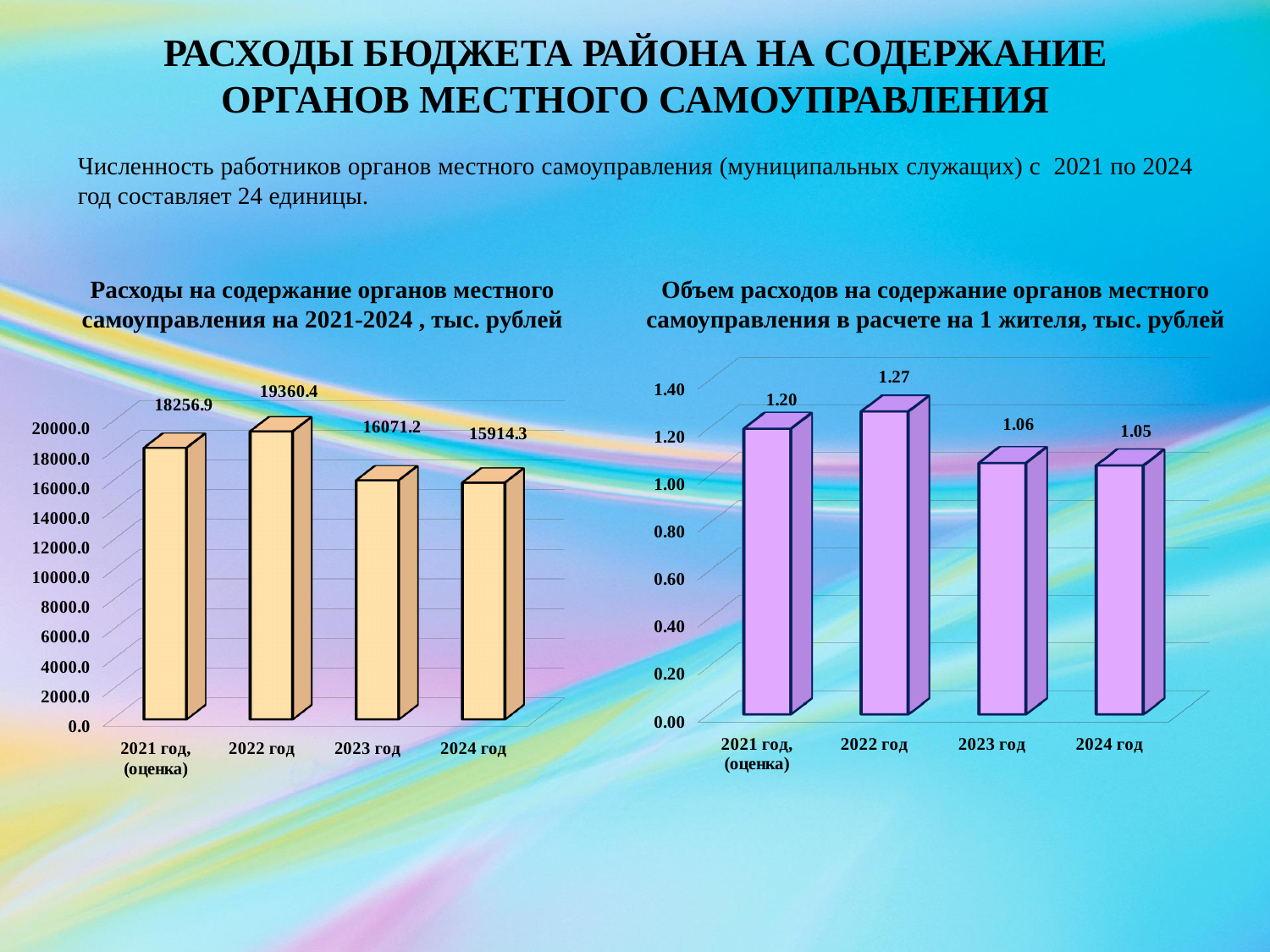
In the left chart (Расходы на содержание органов местного самоуправления на 2021-2024, тыс. рублей), what is the value for 2024 год? 15914.3 In the right chart (Объем расходов на содержание органов местного самоуправления в расчете на 1 жителя, тыс. рублей), what is the value for 2021 год (оценка)? 1.20 In the left chart (Расходы на содержание органов местного самоуправления на 2021-2024, тыс. рублей), which year has the highest value? 2022 год In the right chart (Объем расходов на содержание органов местного самоуправления в расчете на 1 жителя, тыс. рублей), is the value for 2022 год greater or less than 1.20? greater In the right chart (Объем расходов на содержание органов местного самоуправления в расчете на 1 жителя, тыс. рублей), what is the difference between the values for 2022 год and 2021 год (оценка)? 0.07 In the left chart (Расходы на содержание органов местного самоуправления на 2021-2024, тыс. рублей), how many bars are plotted? 4 In the right chart (Объем расходов на содержание органов местного самоуправления в расчете на 1 жителя, тыс. рублей), what is the value for 2023 год? 1.06 In the left chart (Расходы на содержание органов местного самоуправления на 2021-2024, тыс. рублей), what is the difference between the values for 2022 год and 2021 год (оценка)? 1103.5 What kind of chart is the right chart (Объем расходов на содержание органов местного самоуправления в расчете на 1 жителя, тыс. рублей)? bar chart In the left chart (Расходы на содержание органов местного самоуправления на 2021-2024, тыс. рублей), which year has the lowest value? 2024 год In the right chart (Объем расходов на содержание органов местного самоуправления в расчете на 1 жителя, тыс. рублей), which year has the highest value? 2022 год In the left chart (Расходы на содержание органов местного самоуправления на 2021-2024, тыс. рублей), what is the value for 2022 год? 19360.4